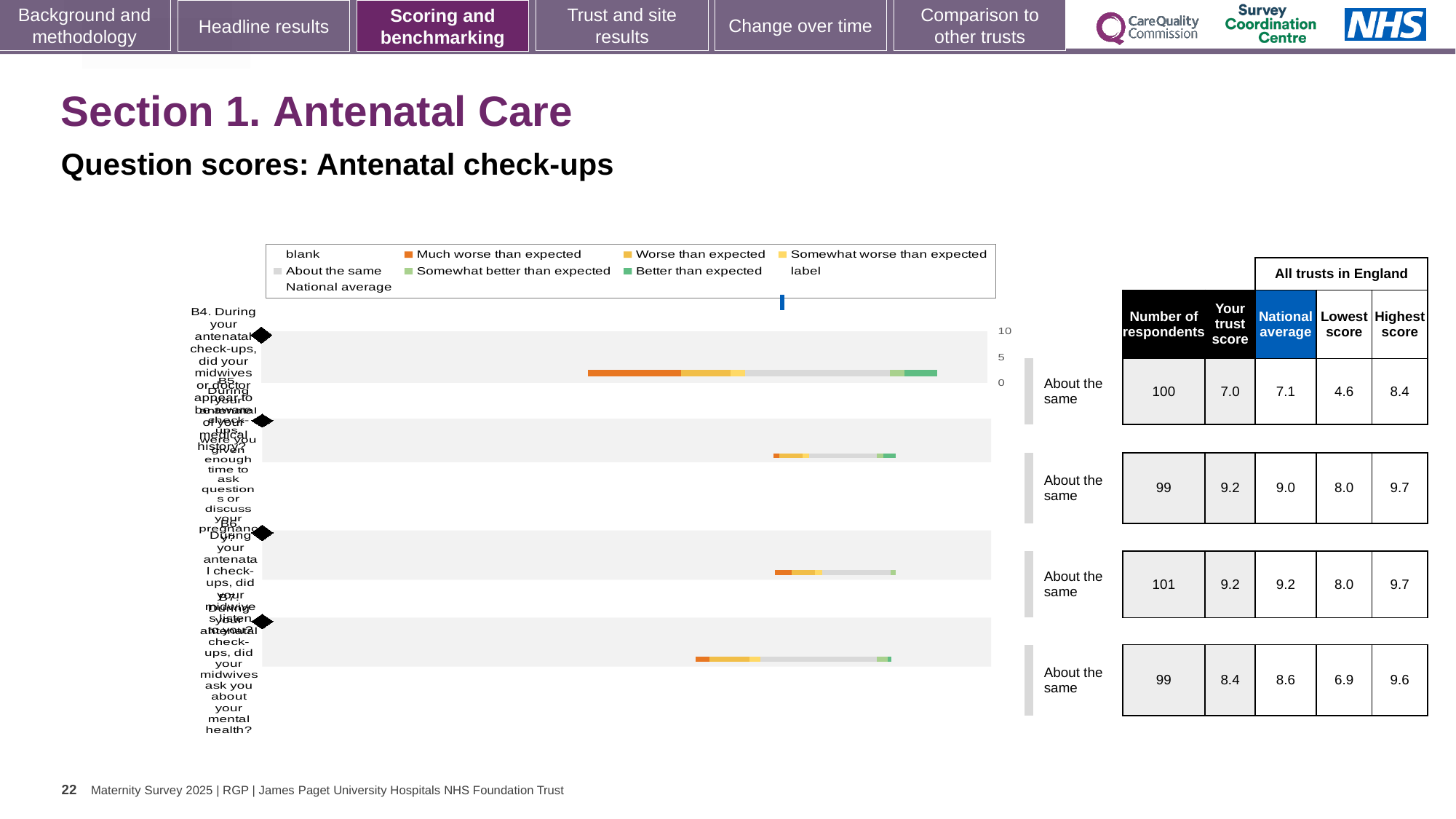
For the last question (B7), which is larger: the trust score or the national average? National average (8.6) According to the legend, what does the dark green segment of the bars represent? Better than expected What benchmark category is shown for each of the four questions on the slide? About the same In the table beside the chart, what is the lowest score across all trusts in England for the last question (B7)? 6.9 Which question has the lowest 'Your trust score' in the table beside the chart? B4 (midwives or doctor aware of your medical history), 7.0 In the table beside the chart, what is the national average for the last question (B7, midwives ask you about your mental health)? 8.6 According to the legend, what does the orange segment of the bars represent? Much worse than expected For the first question (B4), what is the difference between the highest score and the lowest score across all trusts in England? 3.8 What kind of chart is shown on the slide? Bar chart In the table beside the chart, what is the 'Your trust score' for the first question (B4, midwives or doctor aware of your medical history)? 7.0 How many question bars are plotted in the chart? 4 In the table beside the chart, how many respondents are listed for the third question? 101